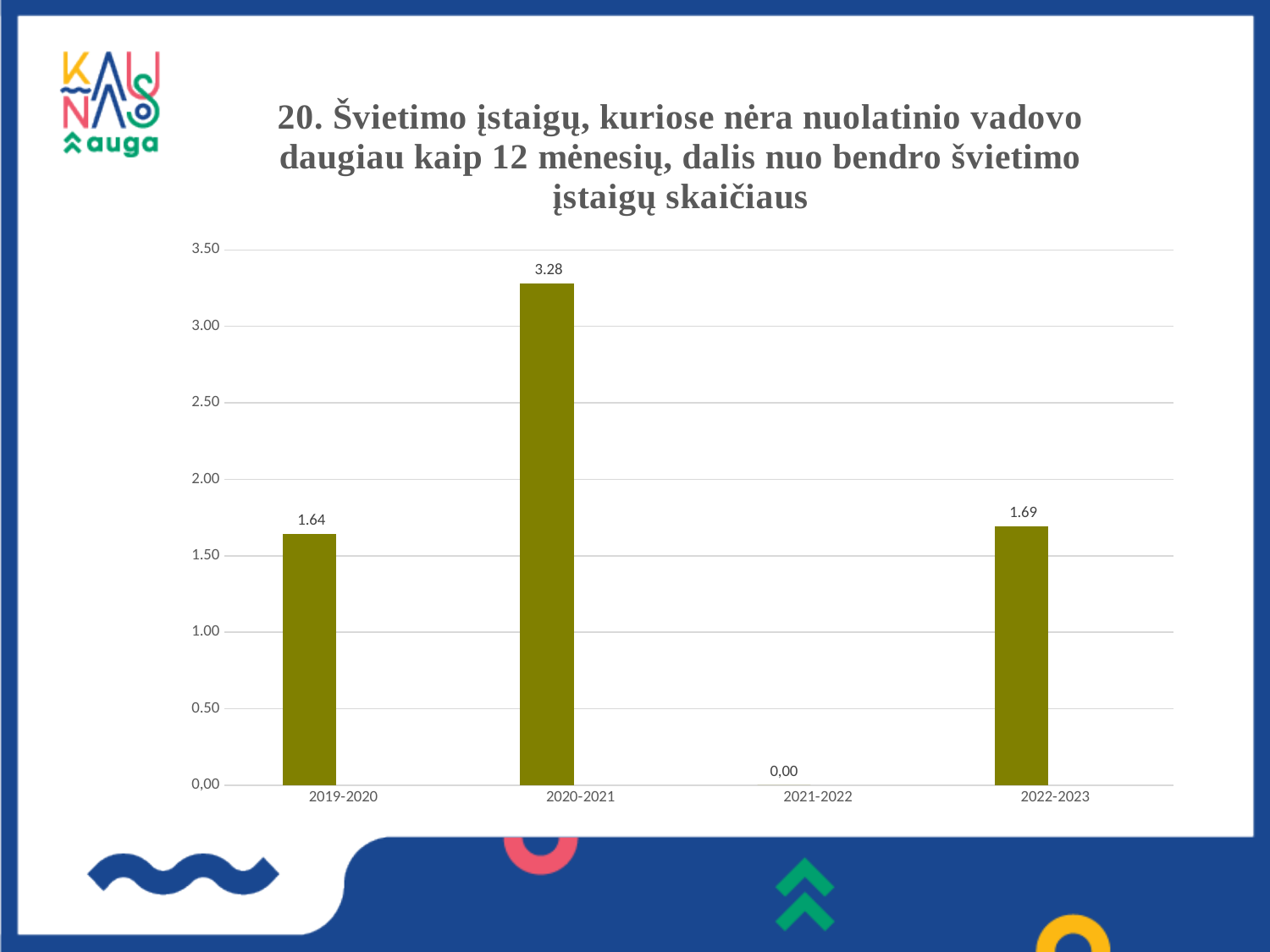
Is the value for 2020-2021 greater or less than 3.00? greater Which is larger, the value for 2022-2023 or the value for 2019-2020? 2022-2023 What is the difference between the values for 2020-2021 and 2019-2020? 1.64 What is the value for 2022-2023? 1.69 What kind of chart is shown on the slide? bar chart What is the value for 2021-2022? 0,00 How many periods are shown on the x axis? 4 What is the value for 2020-2021? 3.28 Which period has the highest value? 2020-2021 What is the value for 2019-2020? 1.64 Which period has the lowest value? 2021-2022 What is the difference between the values for 2020-2021 and 2022-2023? 1.59